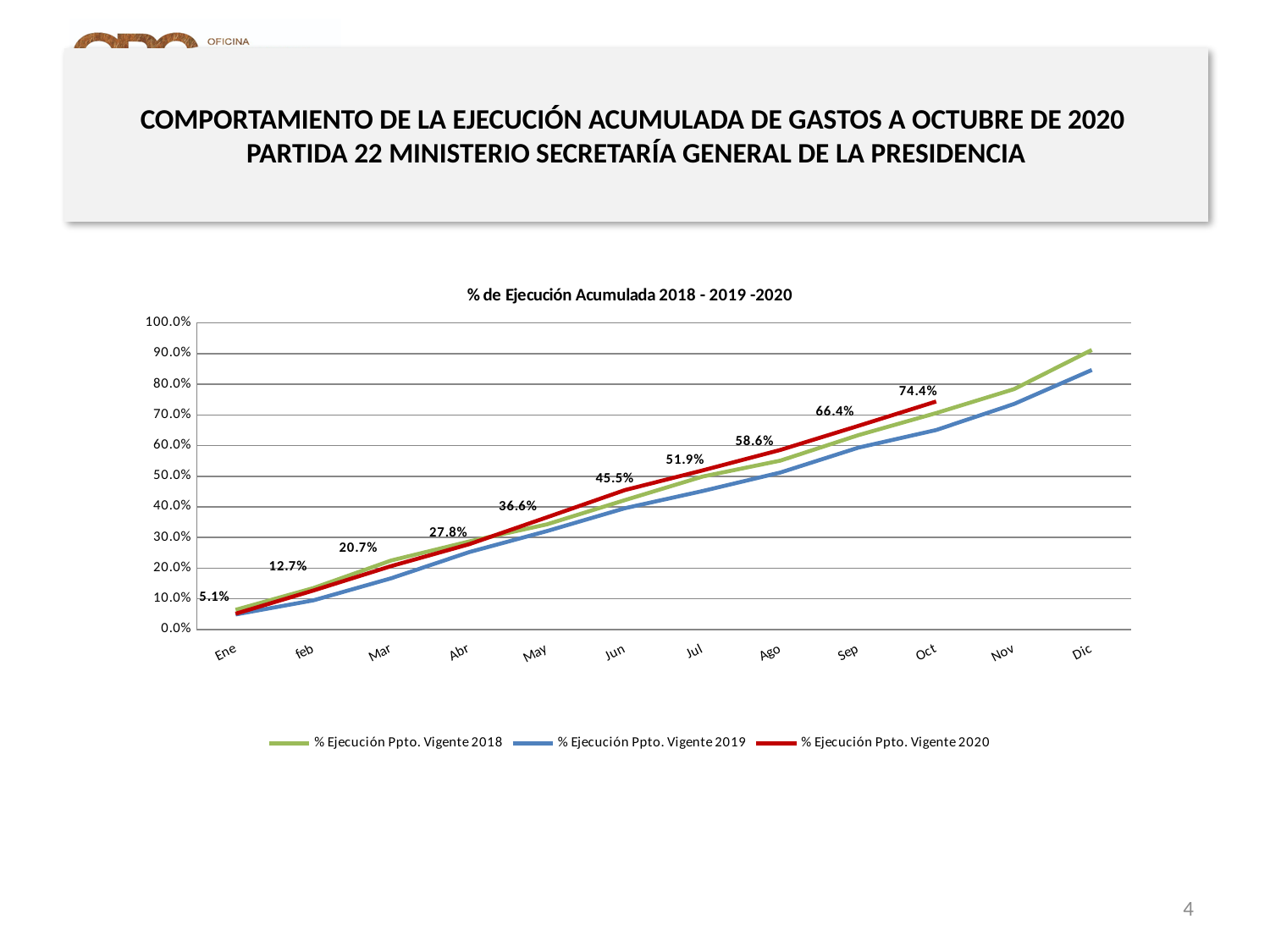
Is the value for % Ejecución Ppto. Vigente 2019 in Dic greater or less than 80.0%? greater Which month has the highest labelled value for % Ejecución Ppto. Vigente 2020? Oct What kind of chart is shown on the slide? Line chart What is the difference between the 2020 values for Jul and Jun? 6.4% What is the value of % Ejecución Ppto. Vigente 2020 in Jun? 45.5% What is the value of % Ejecución Ppto. Vigente 2020 in Mar? 20.7% In Nov, which series is higher: % Ejecución Ppto. Vigente 2018 or % Ejecución Ppto. Vigente 2019? % Ejecución Ppto. Vigente 2018 What is the value of % Ejecución Ppto. Vigente 2020 in Oct? 74.4% How many series does the legend list? 3 What is the value of % Ejecución Ppto. Vigente 2020 in Ene? 5.1% Which month has the lowest labelled value for % Ejecución Ppto. Vigente 2020? Ene What is the difference between the 2020 values for Oct and Sep? 8.0%